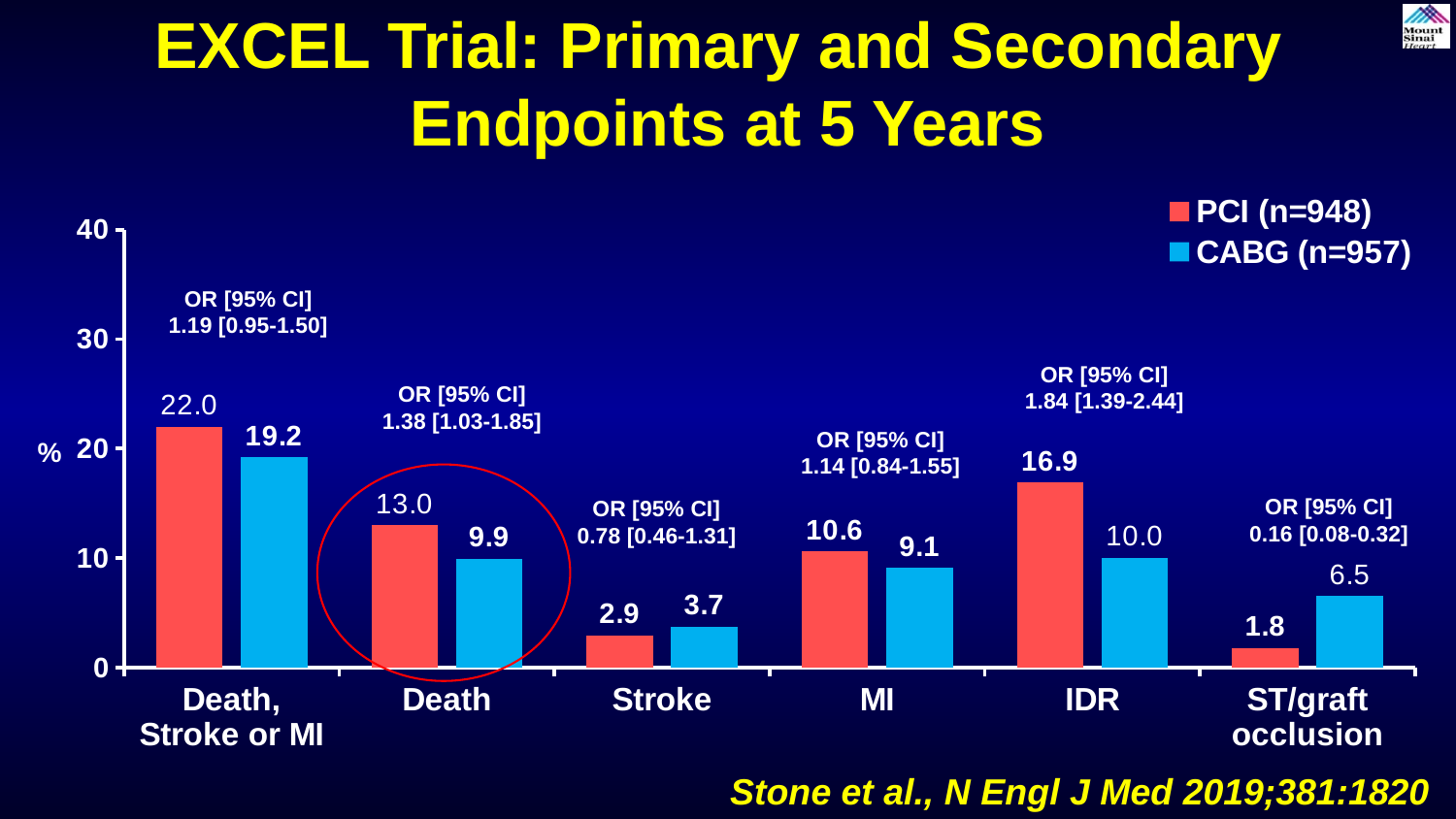
What is the OR [95% CI] shown for IDR? 1.84 [1.39-2.44] What kind of chart is shown on the slide? Bar chart What is the CABG value for ST/graft occlusion? 6.5 What is the PCI value for Death, Stroke or MI? 22.0 What is the difference between the PCI and CABG values for Death? 3.1 How many series does the legend list? 2 Which is larger for Stroke, the PCI value or the CABG value? CABG What is the CABG value for IDR? 10.0 Which category has the highest PCI value? Death, Stroke or MI How many categories are shown on the x axis? 6 Which category has the lowest PCI value? ST/graft occlusion What is the difference between the PCI and CABG values for IDR? 6.9